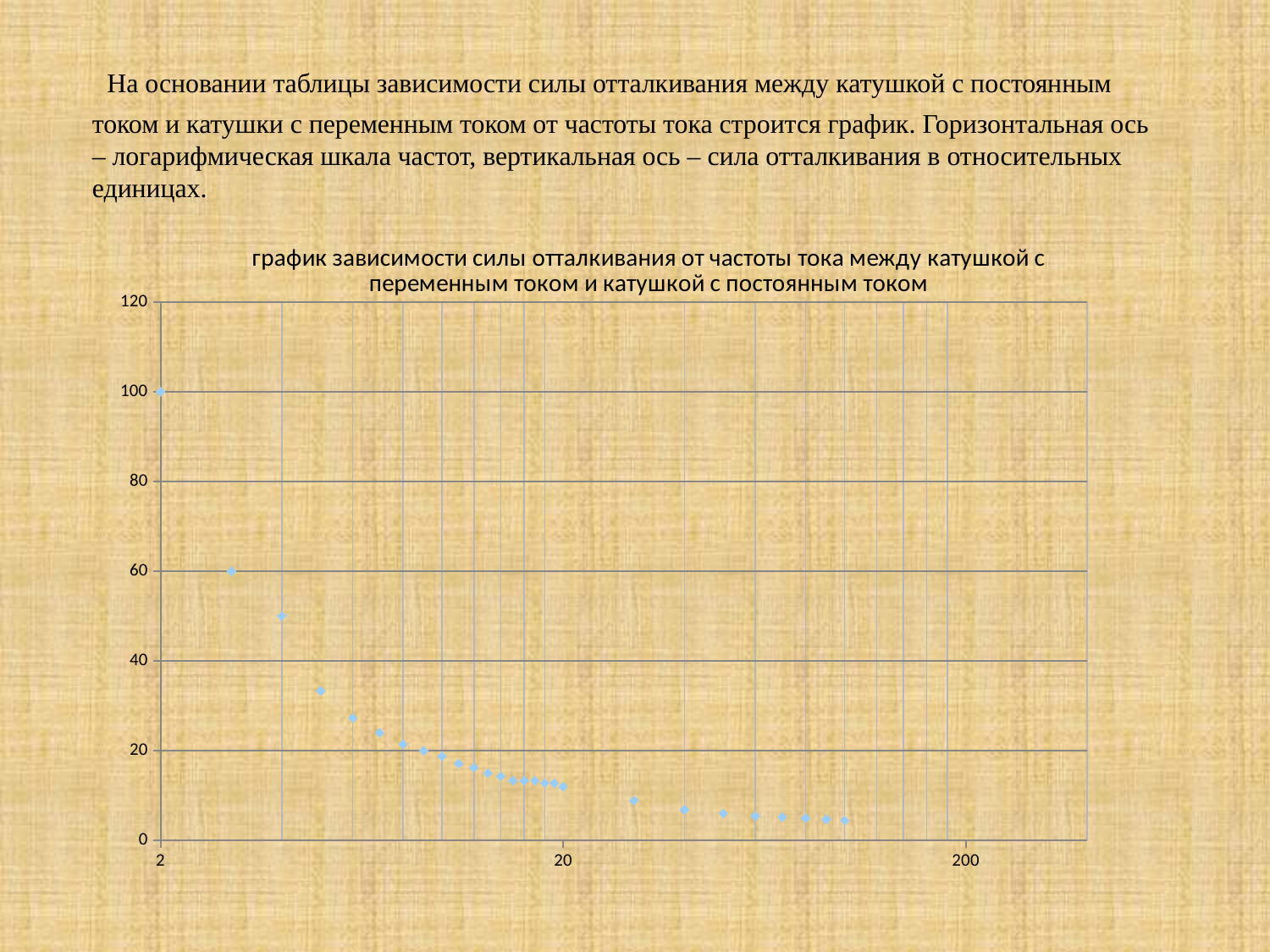
Is the value of the second point from the left greater or less than 40? greater What kind of chart is shown on the slide? scatter chart Is the value of the third point from the left greater or less than 60? less What is the maximum value shown on the vertical axis? 120 Is the value of the rightmost point on the chart greater or less than 20? less Which point has the larger value: the leftmost point or the rightmost point? the leftmost point Do the plotted values rise or fall as the frequency increases along the x axis? fall What is the title of the chart? график зависимости силы отталкивания от частоты тока между катушкой с переменным током и катушкой с постоянным током What is the highest plotted value of the repulsion force on the chart? 100 What is the value of the first point, at frequency 2? 100